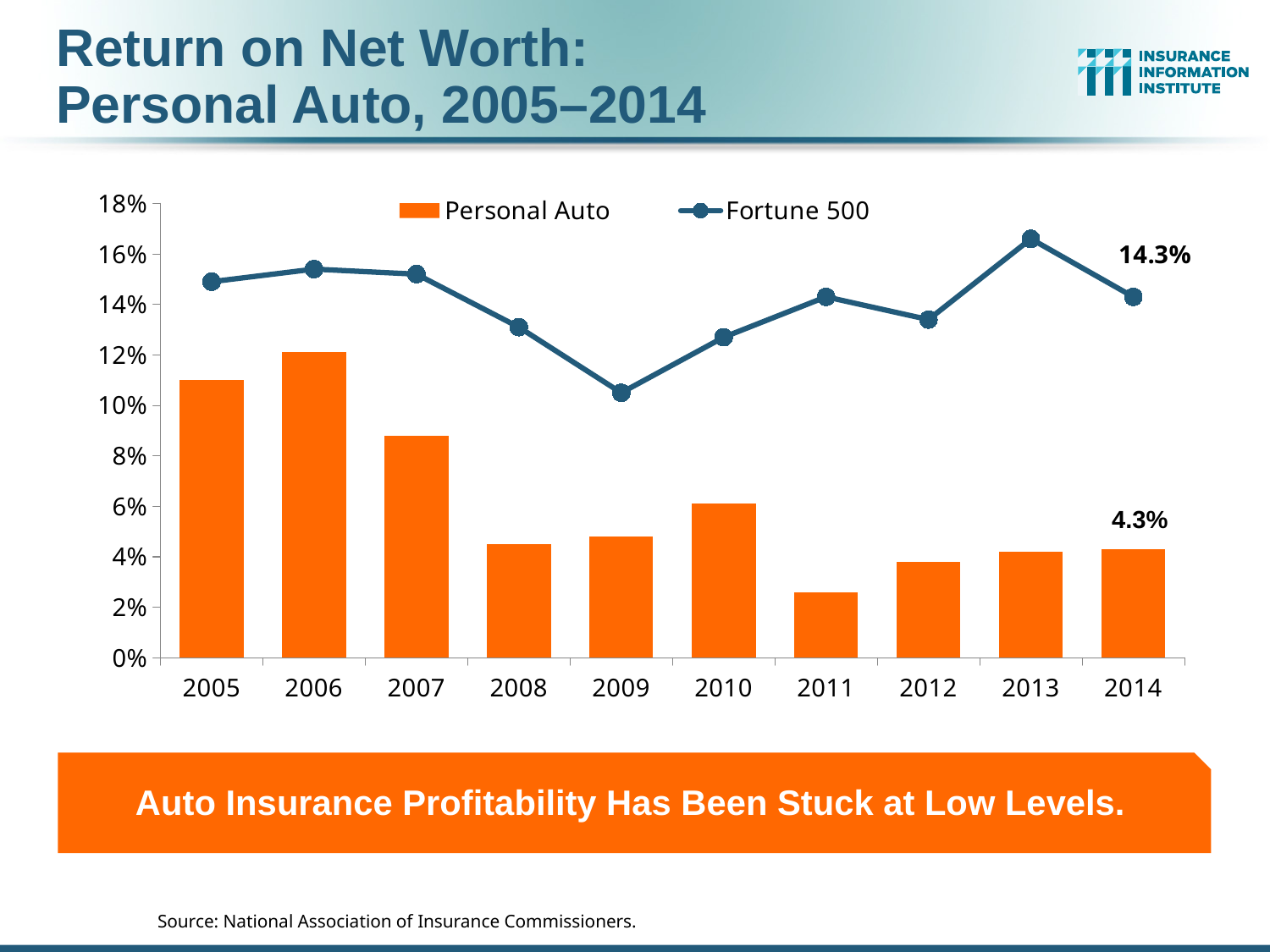
Is the Personal Auto value for 2011 greater or less than 4%? less In 2014, how much higher is the Fortune 500 value than the Personal Auto value? 10 percentage points In which year does the Fortune 500 line reach its highest point? 2013 Is the Fortune 500 value for 2009 greater or less than 12%? less How many series does the legend list? 2 In which year is the Personal Auto bar the highest? 2006 In which year does the Fortune 500 line reach its lowest point? 2009 What is the Personal Auto return on net worth for 2014? 4.3% How many years are shown on the x axis? 10 In which year is the Personal Auto bar the lowest? 2011 What is the Fortune 500 return on net worth for 2014? 14.3% Which year has the larger Personal Auto value, 2005 or 2007? 2005